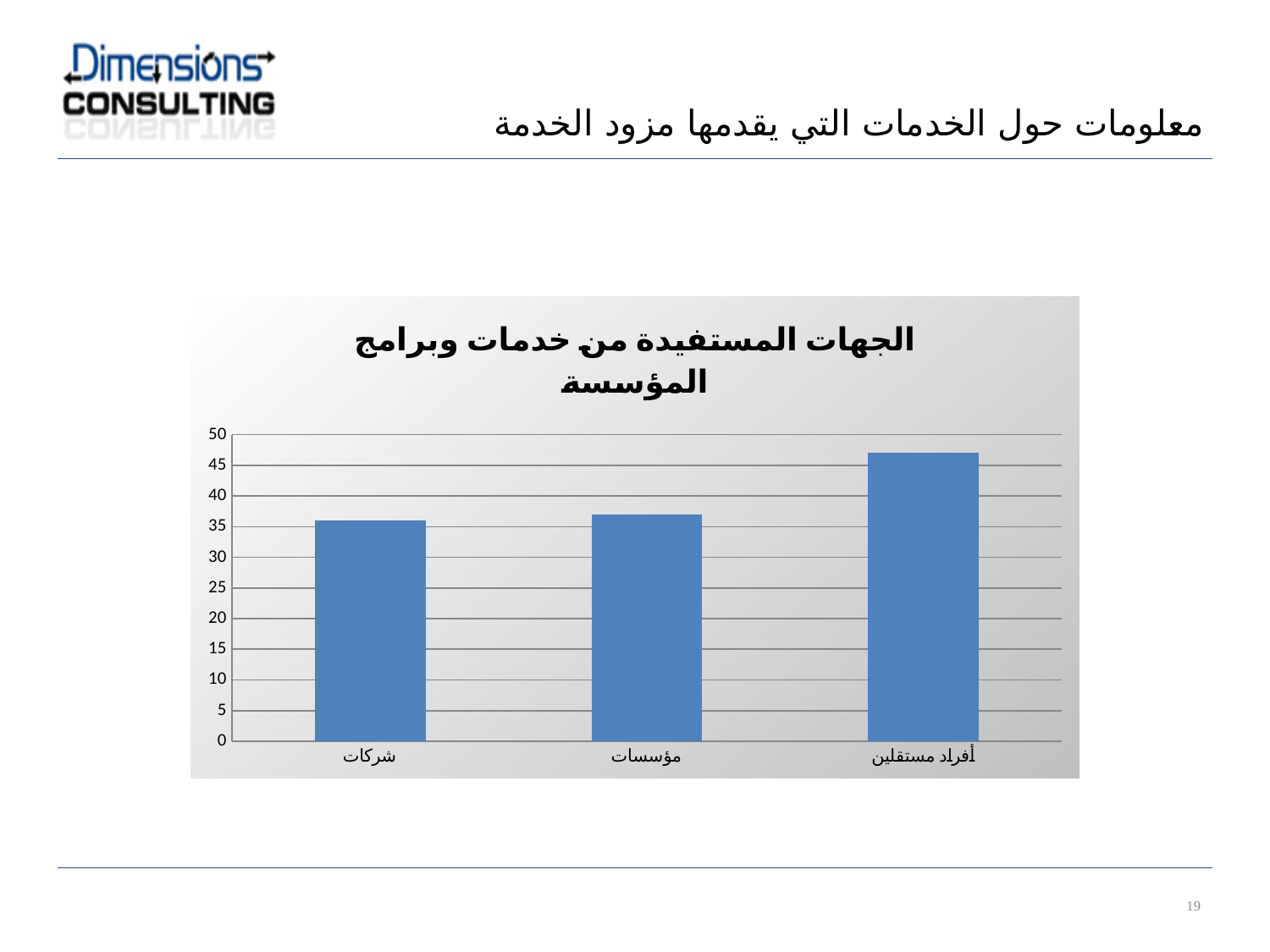
What colour are the bars in the chart? blue What kind of chart is shown on the slide? bar chart How many categories are shown on the x axis of the chart? 3 Is the value for شركات greater or less than 30? greater Is the value for أفراد مستقلين greater or less than 50? less Which is larger, the value for أفراد مستقلين or the value for شركات? أفراد مستقلين What is the title of the chart? الجهات المستفيدة من خدمات وبرامج المؤسسة Is the value for شركات greater or less than 40? less Which category has the highest bar in the chart? أفراد مستقلين